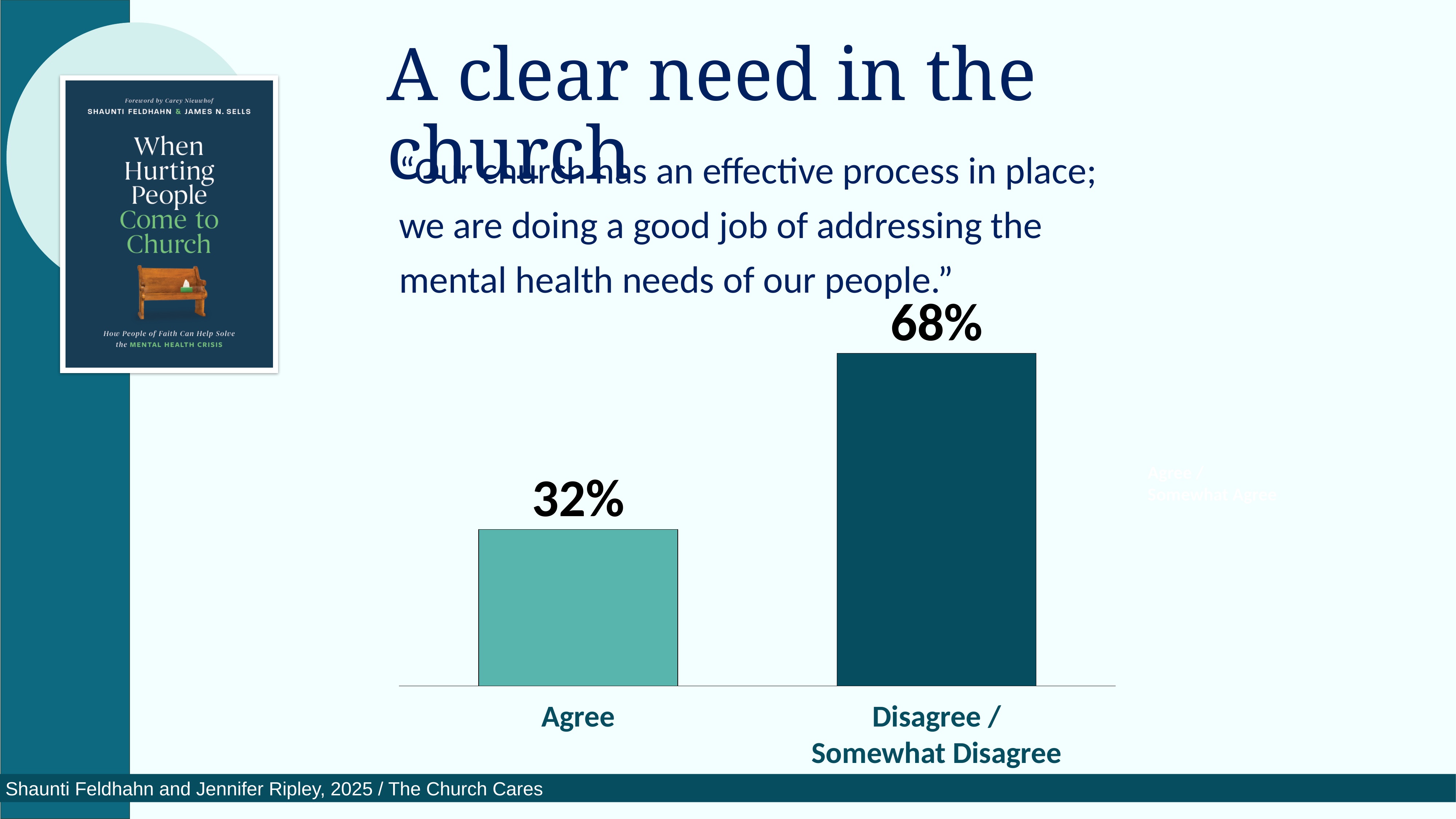
Which category has the highest value? Disagree / Somewhat Disagree Which category has the lowest value? Agree What is the title of the slide containing the chart? A clear need in the church What is the value for Agree? 32% What is the value for Disagree / Somewhat Disagree? 68% What colour is the bar for Disagree / Somewhat Disagree? Dark teal What is the total of the two bar values? 100% How many categories are shown in the chart? 2 Which is larger, the value for Agree or the value for Disagree / Somewhat Disagree? Disagree / Somewhat Disagree What kind of chart is shown on the slide? Bar chart What is the difference between the Disagree / Somewhat Disagree value and the Agree value? 36%